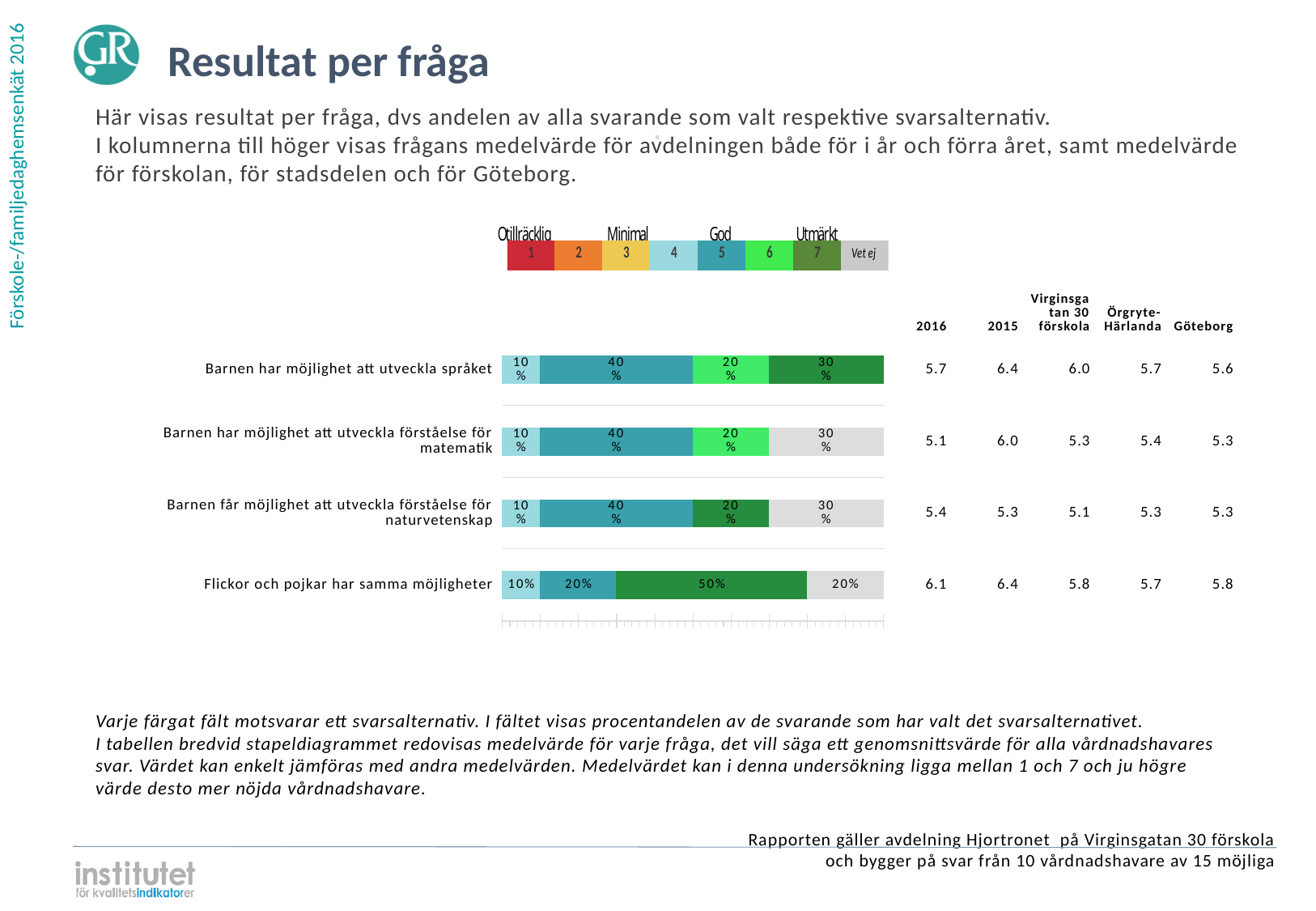
How many questions (categories) are shown as bars in the chart? 4 What percentage is shown for the largest segment of the bar for 'Flickor och pojkar har samma möjligheter'? 50% How many answer options does the legend above the chart list, including 'Vet ej'? 8 What percentage of respondents chose 'Vet ej' (grey segment) for 'Barnen har möjlighet att utveckla förståelse för matematik'? 30% What is the total of the segments in the bar for 'Barnen har möjlighet att utveckla språket'? 100% Which has the higher Göteborg mean value: 'Barnen har möjlighet att utveckla språket' or 'Flickor och pojkar har samma möjligheter'? Flickor och pojkar har samma möjligheter What kind of chart is used to show the results per question? Stacked bar chart Which question has the highest 2016 mean value? Flickor och pojkar har samma möjligheter What is the difference between the 2015 and 2016 mean values for 'Barnen har möjlighet att utveckla språket'? 0.7 What is the Virginsgatan 30 förskola mean value for 'Barnen får möjlighet att utveckla förståelse för naturvetenskap'? 5.1 What is the 2016 mean value for 'Flickor och pojkar har samma möjligheter'? 6.1 Which question has the lowest 2016 mean value? Barnen har möjlighet att utveckla förståelse för matematik